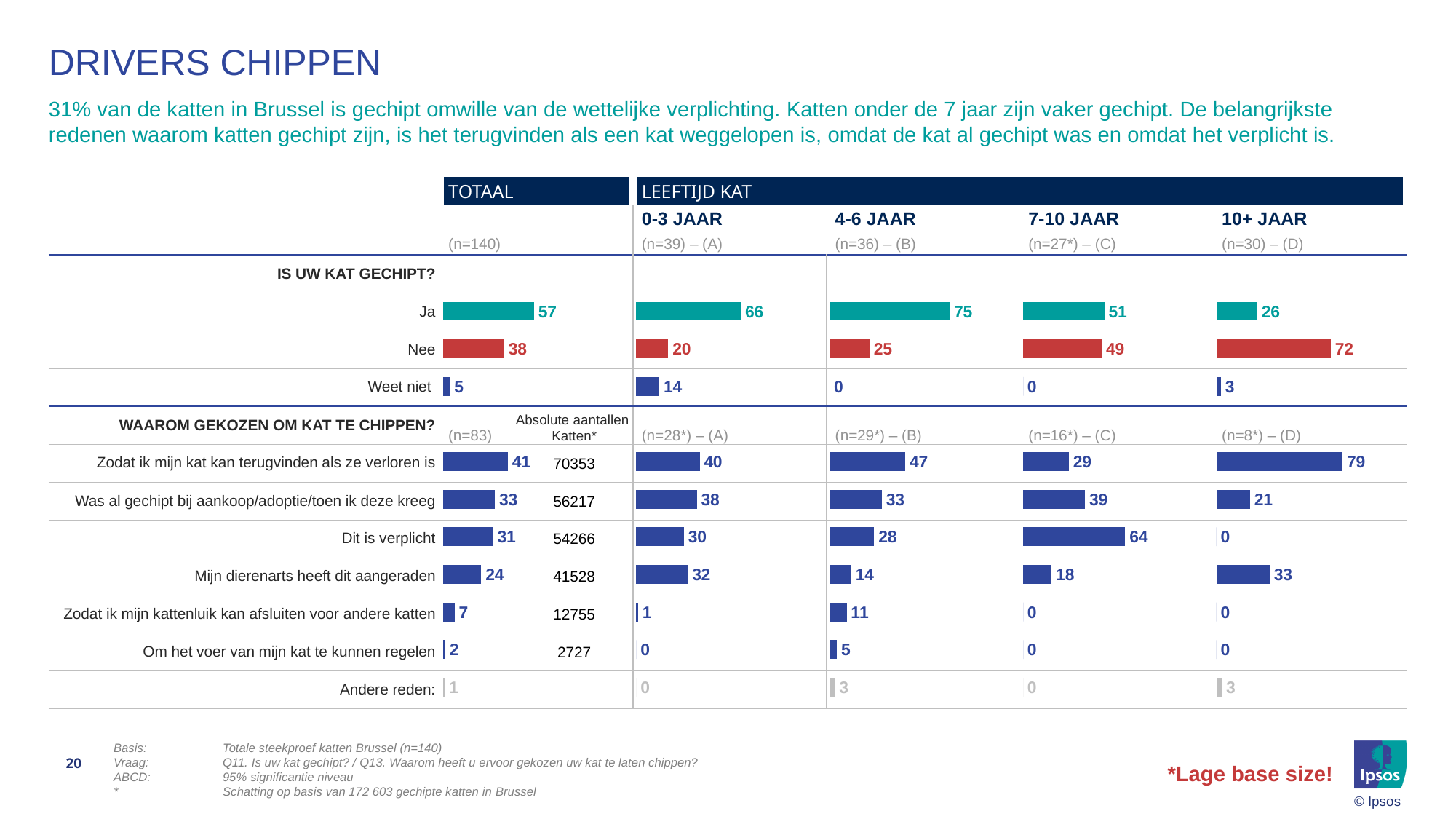
In the TOTAAL column, what is the difference between 'Ja' and 'Nee'? 19 What is the absolute number of cats (Absolute aantallen Katten) for 'Zodat ik mijn kat kan terugvinden als ze verloren is'? 70353 In the 0-3 JAAR column, what is the value for 'Weet niet'? 14 What type of chart is used to display the values in the table? bar chart In the 10+ JAAR column, what is the value for 'Nee'? 72 Is the value for 'Dit is verplicht' larger in the 0-3 JAAR column or the 7-10 JAAR column? 7-10 JAAR Which age group has the lowest value for 'Ja' (cat is chipped)? 10+ JAAR In the 10+ JAAR column, which reason for chipping has the highest value? Zodat ik mijn kat kan terugvinden als ze verloren is How many reasons for chipping are listed under 'WAAROM GEKOZEN OM KAT TE CHIPPEN?' 7 Which age group has the highest value for 'Ja' (cat is chipped)? 4-6 JAAR In the 7-10 JAAR column, what is the value for 'Dit is verplicht'? 64 In the TOTAAL column, what percentage answered 'Ja' to 'Is uw kat gechipt?' 57